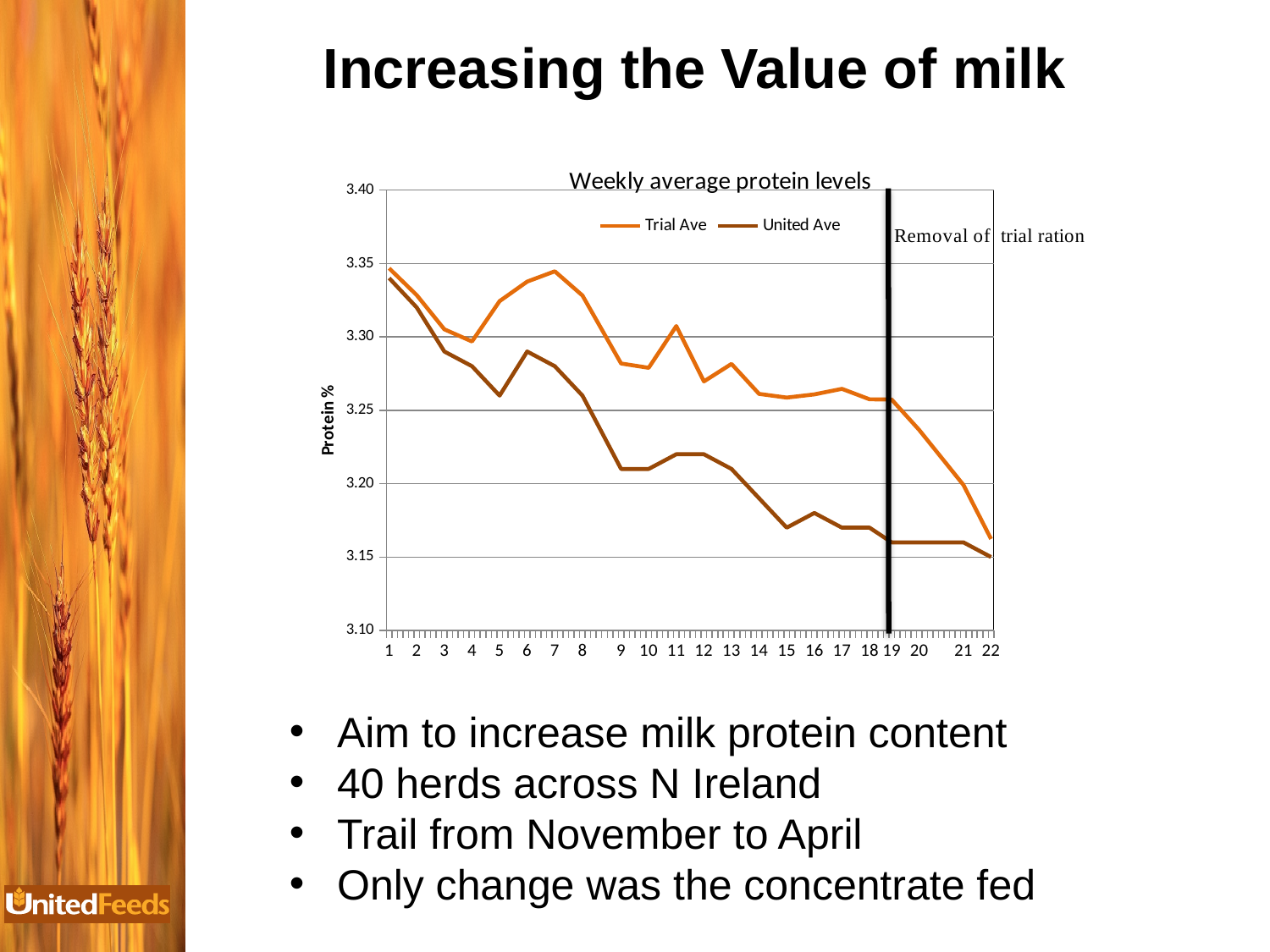
Is the United Ave value at week 9 greater or less than 3.25? less Overall, do the protein levels rise or fall from week 1 to week 22? Fall How many series does the chart legend list? 2 How many weeks are plotted along the x axis of the chart? 22 Is the United Ave value at week 22 greater or less than 3.20? less Which week has the lowest United Ave protein level? 22 What is the title of the chart? Weekly average protein levels Is the Trial Ave value at week 1 greater or less than 3.30? greater What is the label on the y axis of the chart? Protein % What kind of chart is shown on the slide? Line chart At week 9, which series has the higher protein level, Trial Ave or United Ave? Trial Ave Which week has the lowest Trial Ave protein level? 22